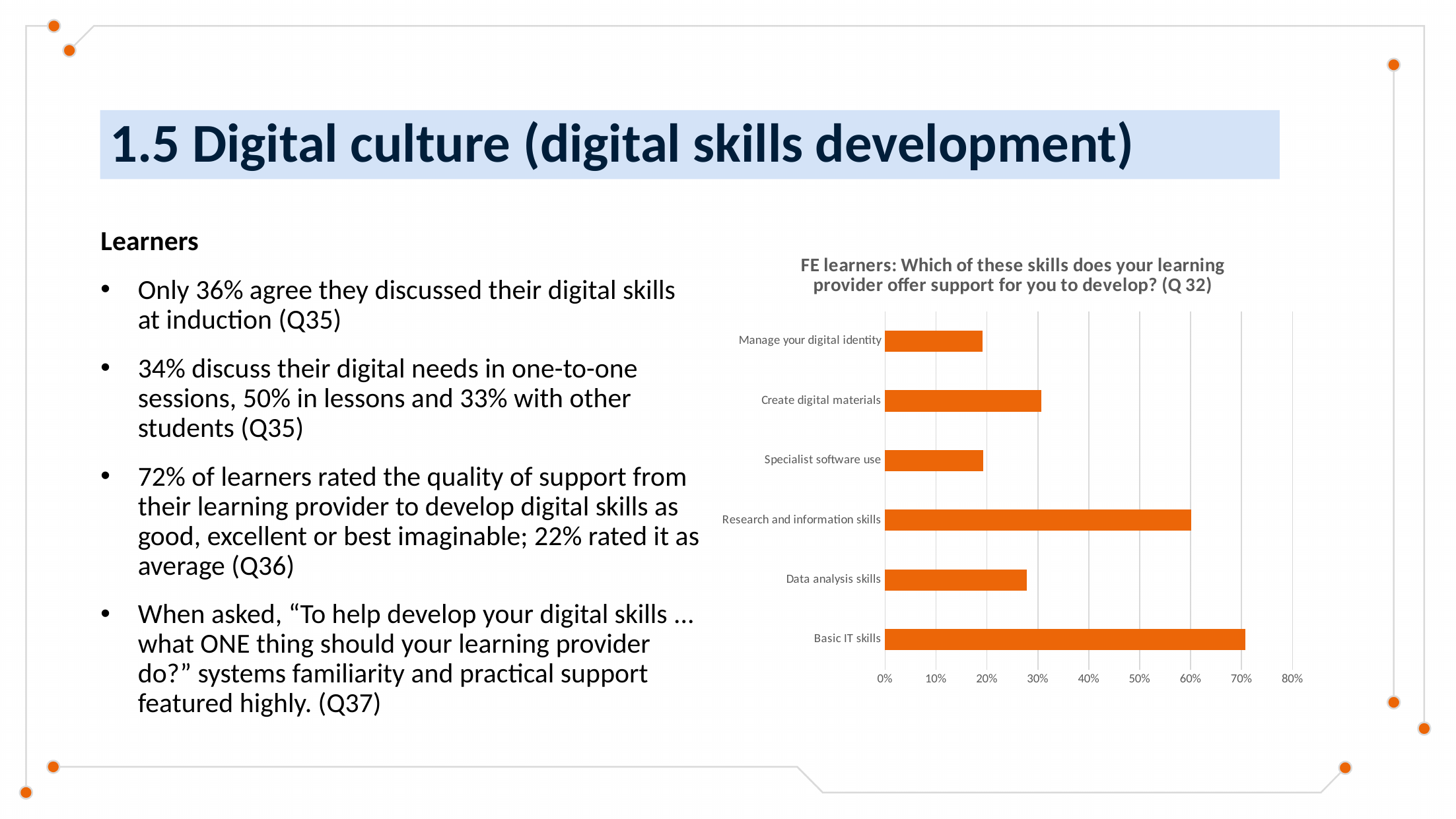
Which skill has the highest value in the chart? Basic IT skills Which is larger: the value for Research and information skills or the value for Data analysis skills? Research and information skills What is the title of the chart? FE learners: Which of these skills does your learning provider offer support for you to develop? (Q 32) What colour are the bars in the chart? orange Is the value for Manage your digital identity greater or less than 30%? less Is the value for Data analysis skills greater or less than 20%? greater Is the value for Research and information skills greater or less than 50%? greater What kind of chart is shown on the slide? bar chart How many skill categories are plotted in the chart? 6 Which is larger: the value for Create digital materials or the value for Specialist software use? Create digital materials